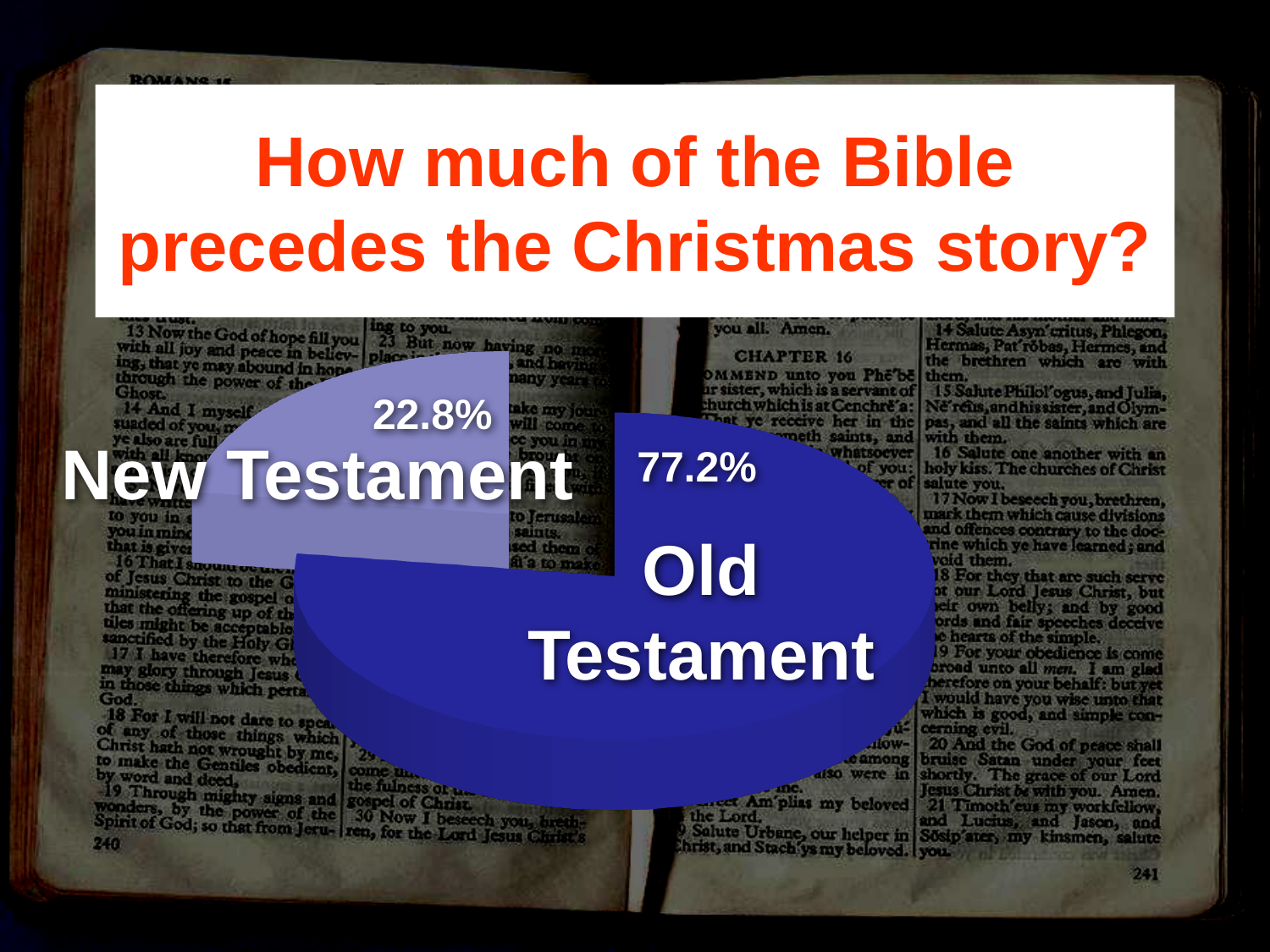
What kind of chart is shown on the slide? pie chart What share of the pie does the Old Testament slice represent? 77.2% What colour is the Old Testament slice? dark blue Which slice of the pie is the largest? Old Testament Is the share for the New Testament greater or less than 25%? less What is the title shown above the chart? How much of the Bible precedes the Christmas story? Is the share for the Old Testament greater or less than 75%? greater What share of the pie does the New Testament slice represent? 22.8% Which is larger, the Old Testament slice or the New Testament slice? Old Testament Which slice of the pie is the smallest? New Testament What is the difference in percentage points between the Old Testament and New Testament slices? 54.4 How many slices does the pie chart have? 2